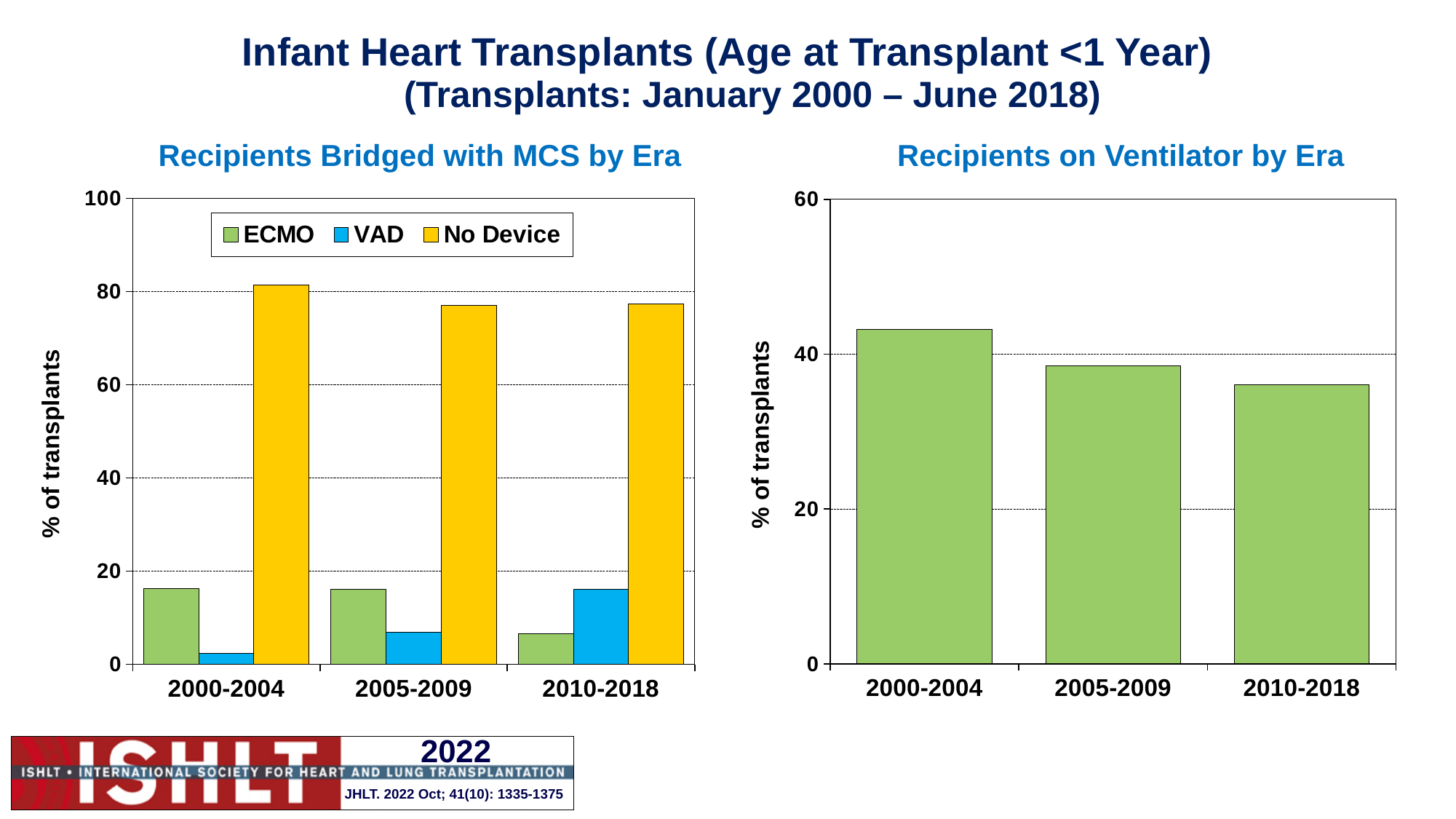
In the 'Recipients Bridged with MCS by Era' chart, is the No Device value for 2000-2004 greater or less than 80? greater How many era categories are shown on the x axis of the 'Recipients on Ventilator by Era' chart? 3 What kind of chart is the 'Recipients Bridged with MCS by Era' chart? bar chart In the 'Recipients Bridged with MCS by Era' chart, which is larger for 2005-2009: ECMO or VAD? ECMO In the 'Recipients on Ventilator by Era' chart, is the value for 2010-2018 greater or less than 40? less In the 'Recipients on Ventilator by Era' chart, which era has the highest value? 2000-2004 In the 'Recipients Bridged with MCS by Era' chart, is the VAD value for 2010-2018 greater or less than 20? less In the 'Recipients Bridged with MCS by Era' chart, which era has the highest VAD value? 2010-2018 How many series does the legend of the 'Recipients Bridged with MCS by Era' chart list? 3 What colour are the bars in the 'Recipients on Ventilator by Era' chart? green In the 'Recipients Bridged with MCS by Era' chart, which era has the lowest ECMO value? 2010-2018 In the 'Recipients on Ventilator by Era' chart, do the values rise or fall across the eras from 2000-2004 to 2010-2018? fall